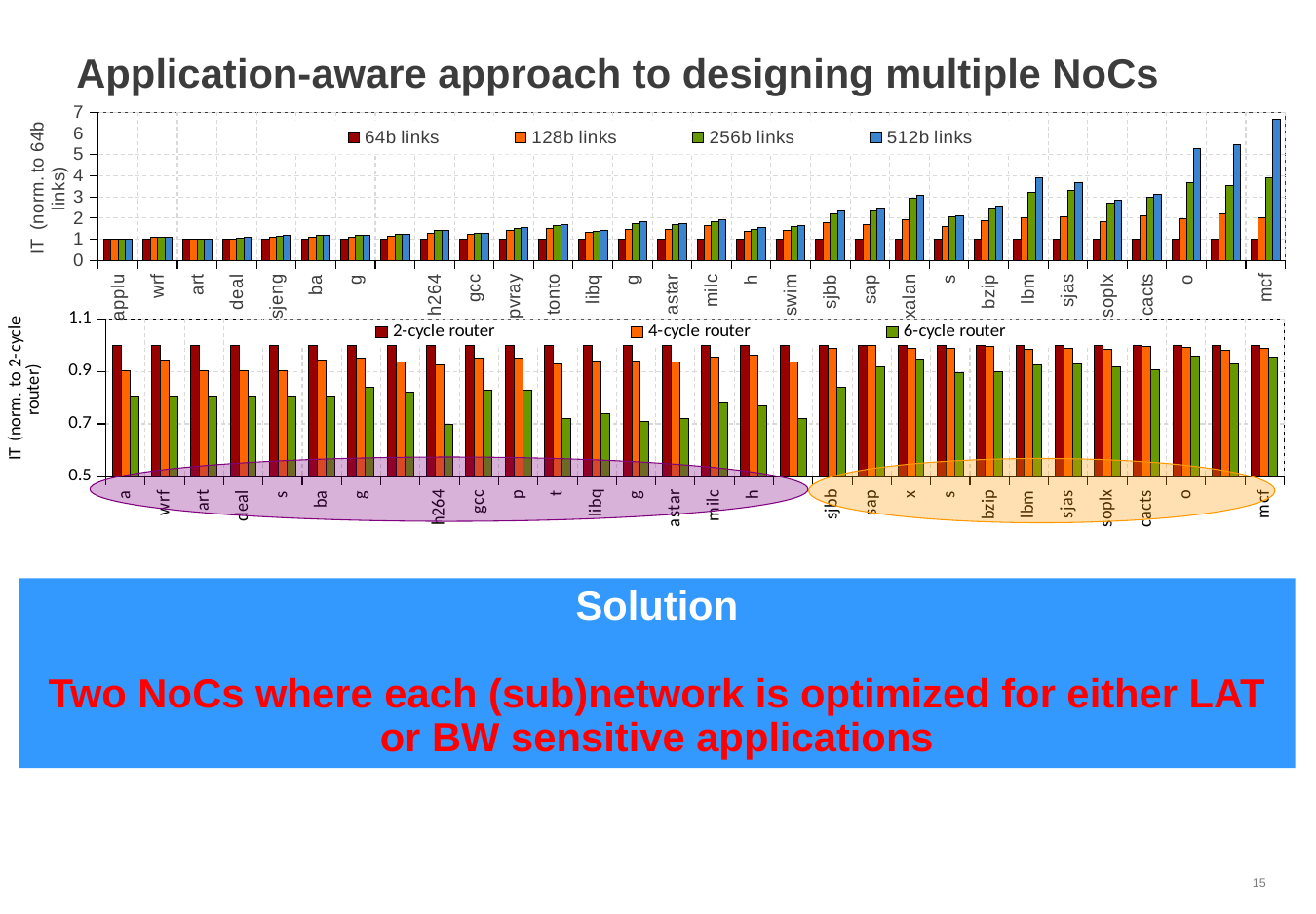
How many series does the legend of the bottom chart list? 3 What is the y-axis title of the bottom chart? IT (norm. to 2-cycle router) In the top chart, which category has the highest value for 512b links? mcf In the bottom chart, which is larger for wrf: the 2-cycle router or the 6-cycle router? 2-cycle router In the top chart, which is larger for 512b links: mcf or lbm? mcf In the top chart, is the 512b links value for mcf greater or less than 6? greater What kind of chart is the top chart on the slide? bar chart In the bottom chart, is the 6-cycle router value for h264 greater or less than 0.9? less In the top chart, is the 512b links value for lbm greater or less than 3? greater In the top chart, do the 512b links values generally rise or fall from left to right along the x axis? rise How many series does the legend of the top chart list? 4